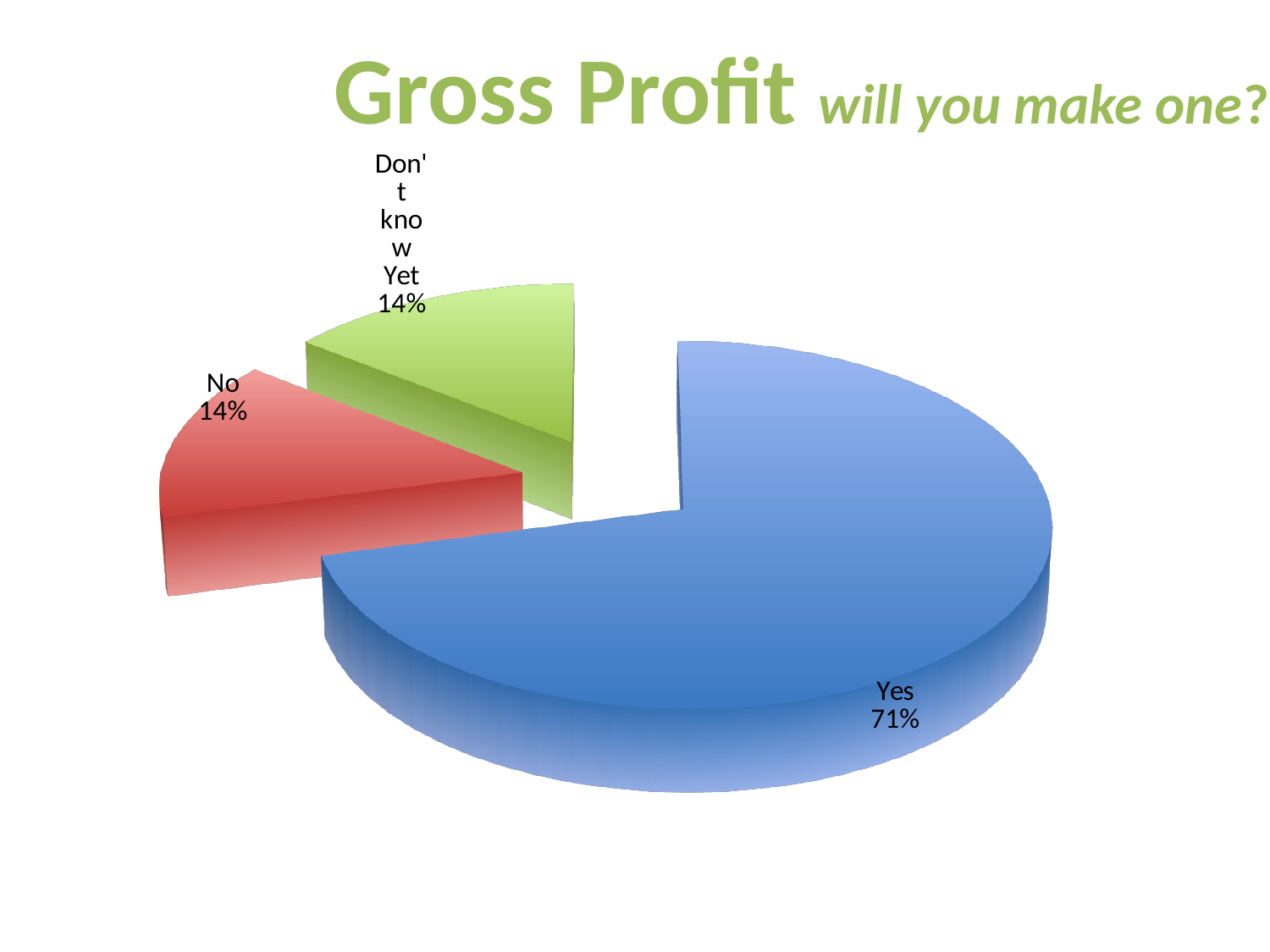
What share of the pie is labelled "Yes"? 71% What share of the pie is labelled "Don't know Yet"? 14% Do the "No" and "Don't know Yet" slices have the same share? Yes, both 14% Which slice of the pie is the largest? Yes What is the difference in percentage points between the "Yes" slice and the "No" slice? 57 What colour is the "Yes" slice? Blue How many slices does the pie chart have? 3 What is the title of the slide containing the chart? Gross Profit will you make one? Which is larger, the "Yes" slice or the "Don't know Yet" slice? Yes What share of the pie is labelled "No"? 14% What kind of chart is shown on the slide? Pie chart